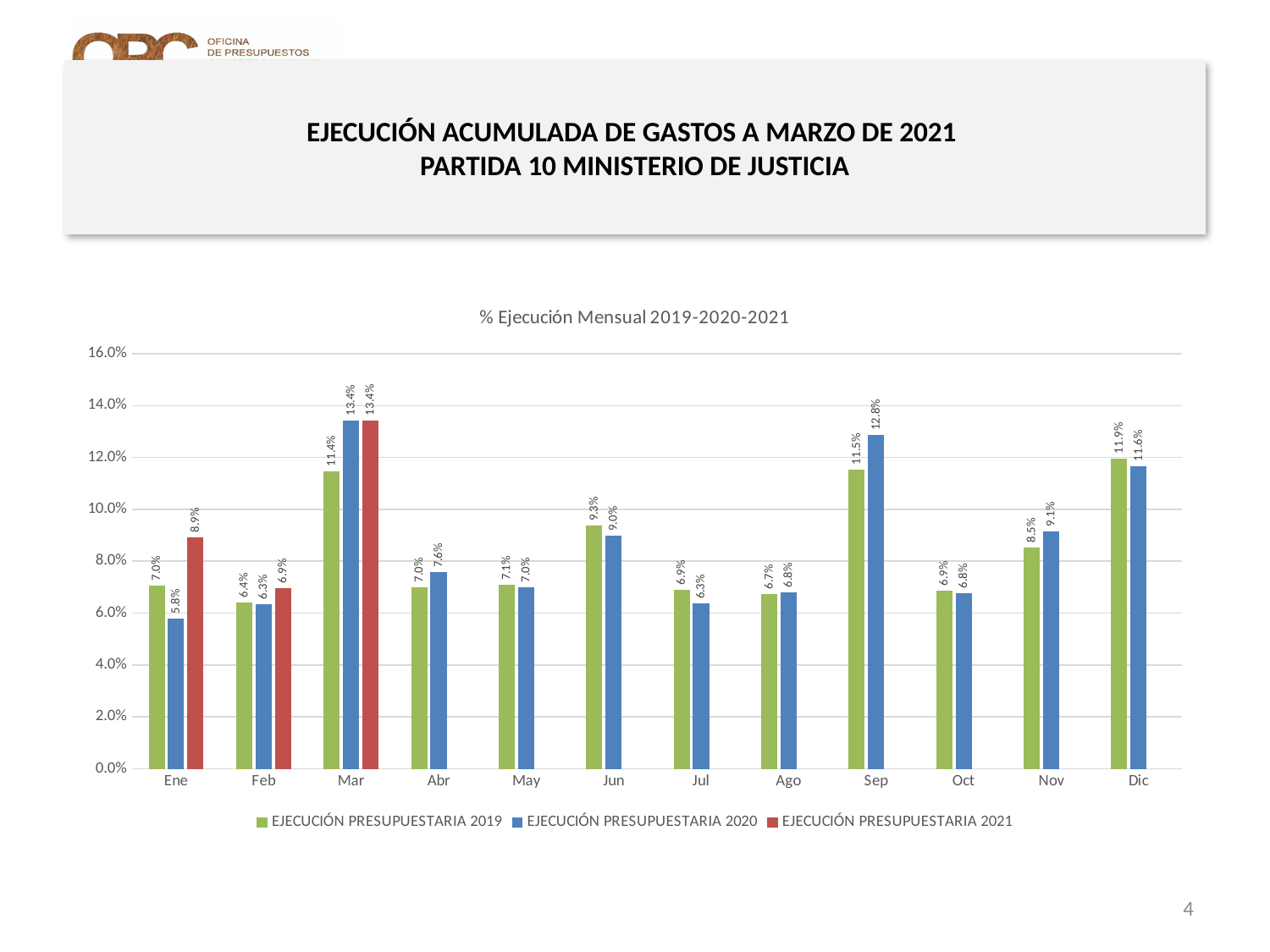
What is the value for EJECUCIÓN PRESUPUESTARIA 2020 in Sep? 12.8% What is the title of the chart? % Ejecución Mensual 2019-2020-2021 Is the EJECUCIÓN PRESUPUESTARIA 2020 value for Sep greater or less than 12.0%? greater Which is larger in Ene: the EJECUCIÓN PRESUPUESTARIA 2019 value or the EJECUCIÓN PRESUPUESTARIA 2021 value? EJECUCIÓN PRESUPUESTARIA 2021 What kind of chart is shown on the slide? Bar chart In which month is the EJECUCIÓN PRESUPUESTARIA 2020 value lowest? Ene What is the value for EJECUCIÓN PRESUPUESTARIA 2019 in Dic? 11.9% How many months are shown on the x axis? 12 What is the value for EJECUCIÓN PRESUPUESTARIA 2021 in Ene? 8.9% How many series does the legend list? 3 What is the difference between the EJECUCIÓN PRESUPUESTARIA 2020 and EJECUCIÓN PRESUPUESTARIA 2019 values in Mar? 2.0% In which month is the EJECUCIÓN PRESUPUESTARIA 2019 value highest? Dic